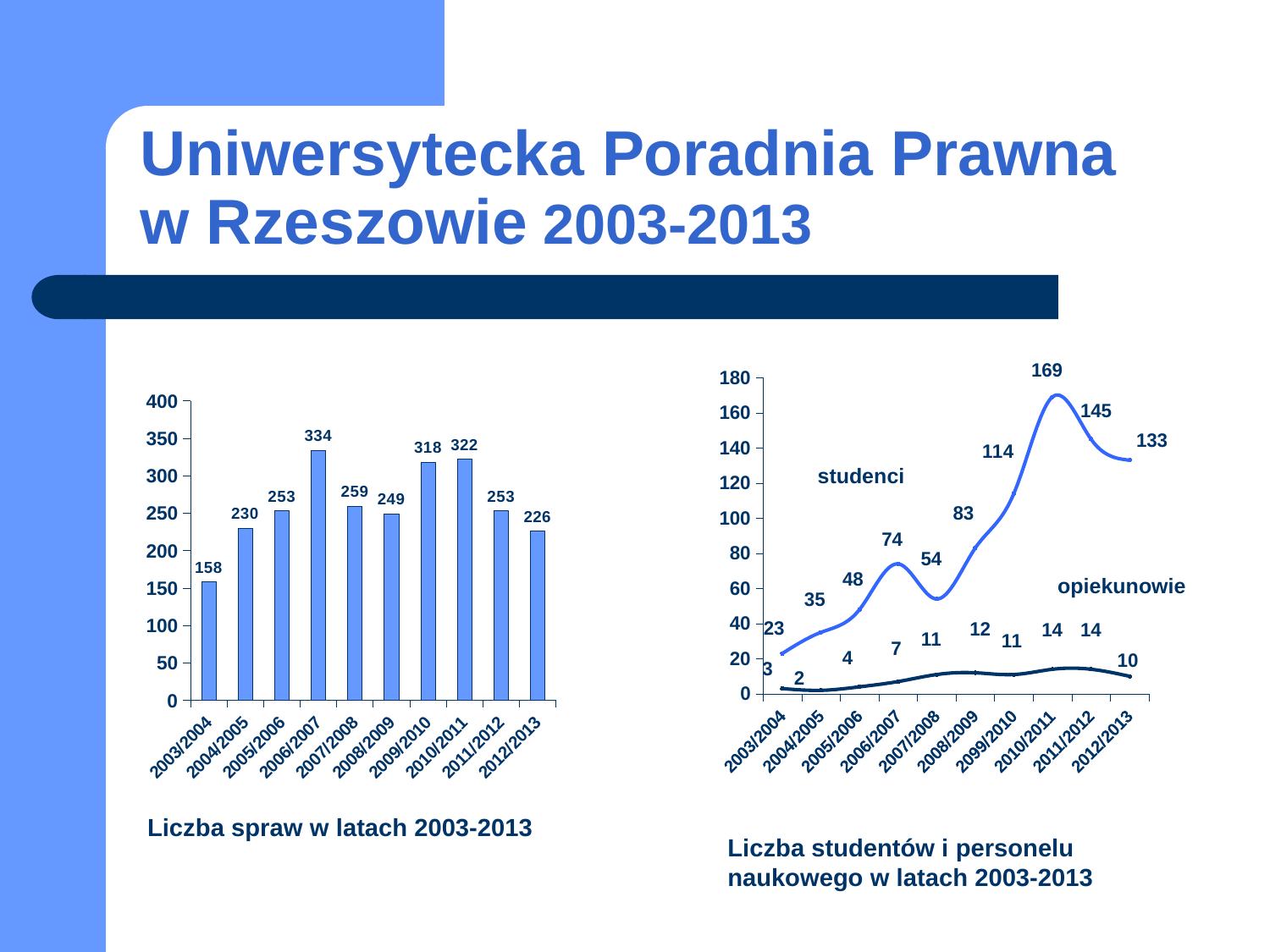
In the right chart (Liczba studentów i personelu naukowego), what is the difference between studenci in 2010/2011 and studenci in 2011/2012? 24 In the left chart (Liczba spraw w latach 2003-2013), which year has the lowest value? 2003/2004 In the left chart (Liczba spraw w latach 2003-2013), how many years are shown on the x axis? 10 In the right chart (Liczba studentów i personelu naukowego), what is the value for opiekunowie in 2004/2005? 2 In the right chart (Liczba studentów i personelu naukowego), how many series are plotted? 2 In the right chart (Liczba studentów i personelu naukowego), which is larger in 2007/2008: studenci or opiekunowie? studenci In the left chart (Liczba spraw w latach 2003-2013), what is the difference between the values for 2010/2011 and 2009/2010? 4 In the left chart (Liczba spraw w latach 2003-2013), what is the value for 2006/2007? 334 What kind of chart is the right chart (Liczba studentów i personelu naukowego)? line chart In the right chart (Liczba studentów i personelu naukowego), what is the value for studenci in 2010/2011? 169 What kind of chart is the left chart (Liczba spraw w latach 2003-2013)? bar chart In the left chart (Liczba spraw w latach 2003-2013), which year has the highest value? 2006/2007